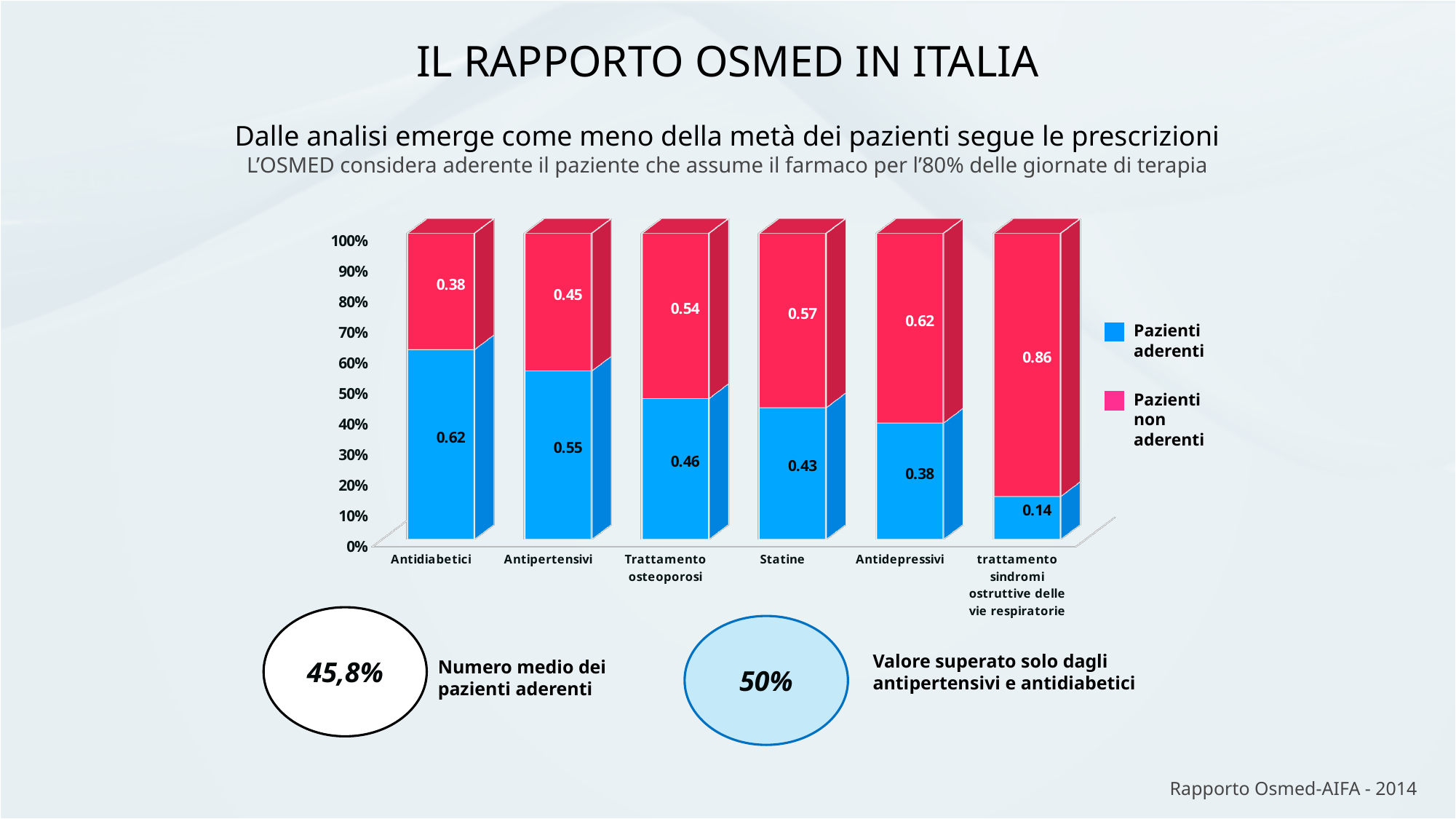
Which is larger: the Pazienti aderenti value for Trattamento osteoporosi or for Statine? Trattamento osteoporosi What kind of chart is shown on the slide? Stacked bar chart How many categories are shown on the x axis? 6 What is the value for Pazienti aderenti for Antidiabetici? 0.62 What is the difference between the Pazienti aderenti values for Antidiabetici and Antipertensivi? 0.07 Which colour represents Pazienti non aderenti in the chart? Pink/red Which category has the highest value for Pazienti non aderenti? trattamento sindromi ostruttive delle vie respiratorie What is the value for Pazienti aderenti for Antidepressivi? 0.38 Which category has the lowest value for Pazienti aderenti? trattamento sindromi ostruttive delle vie respiratorie How many series does the legend list? 2 Do the Pazienti aderenti values rise or fall from left to right along the x axis? Fall What is the value for Pazienti non aderenti for Statine? 0.57